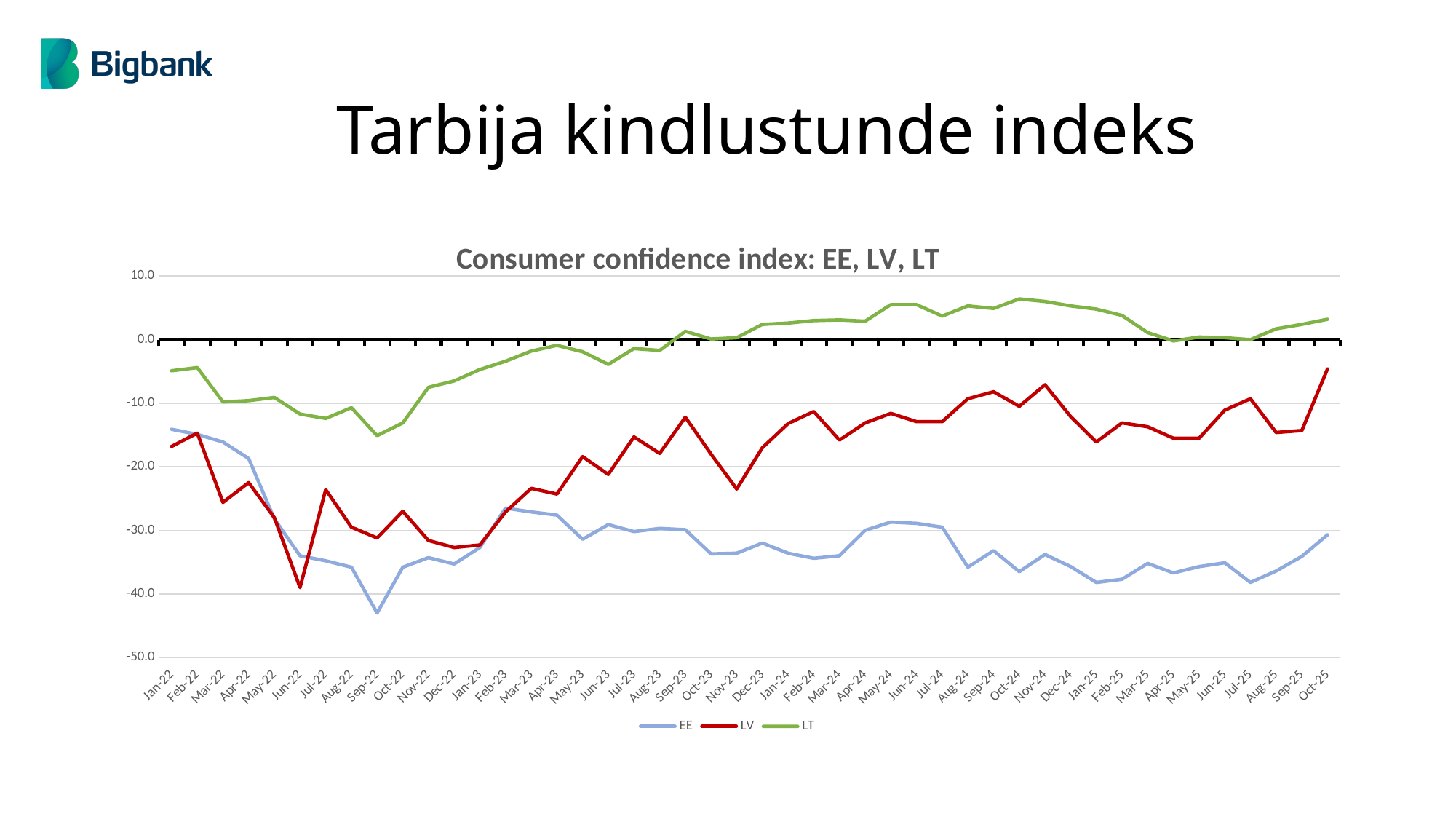
Which series has the highest values across the whole chart? LT Which series are listed in the legend? EE, LV, LT What is the title of the chart? Consumer confidence index: EE, LV, LT Is the value for EE in Sep-22 greater or less than -40.0? less Is the value for LT in Oct-24 greater or less than 0.0? greater Does the EE series rise or fall from Jan-22 to Sep-22? fall Is the value for LV in Oct-25 greater or less than -10.0? greater How many monthly points are plotted along the x axis, from Jan-22 to Oct-25? 46 How many series does the legend list? 3 What kind of chart is shown on the slide? line chart In which month does the EE series reach its lowest point? Sep-22